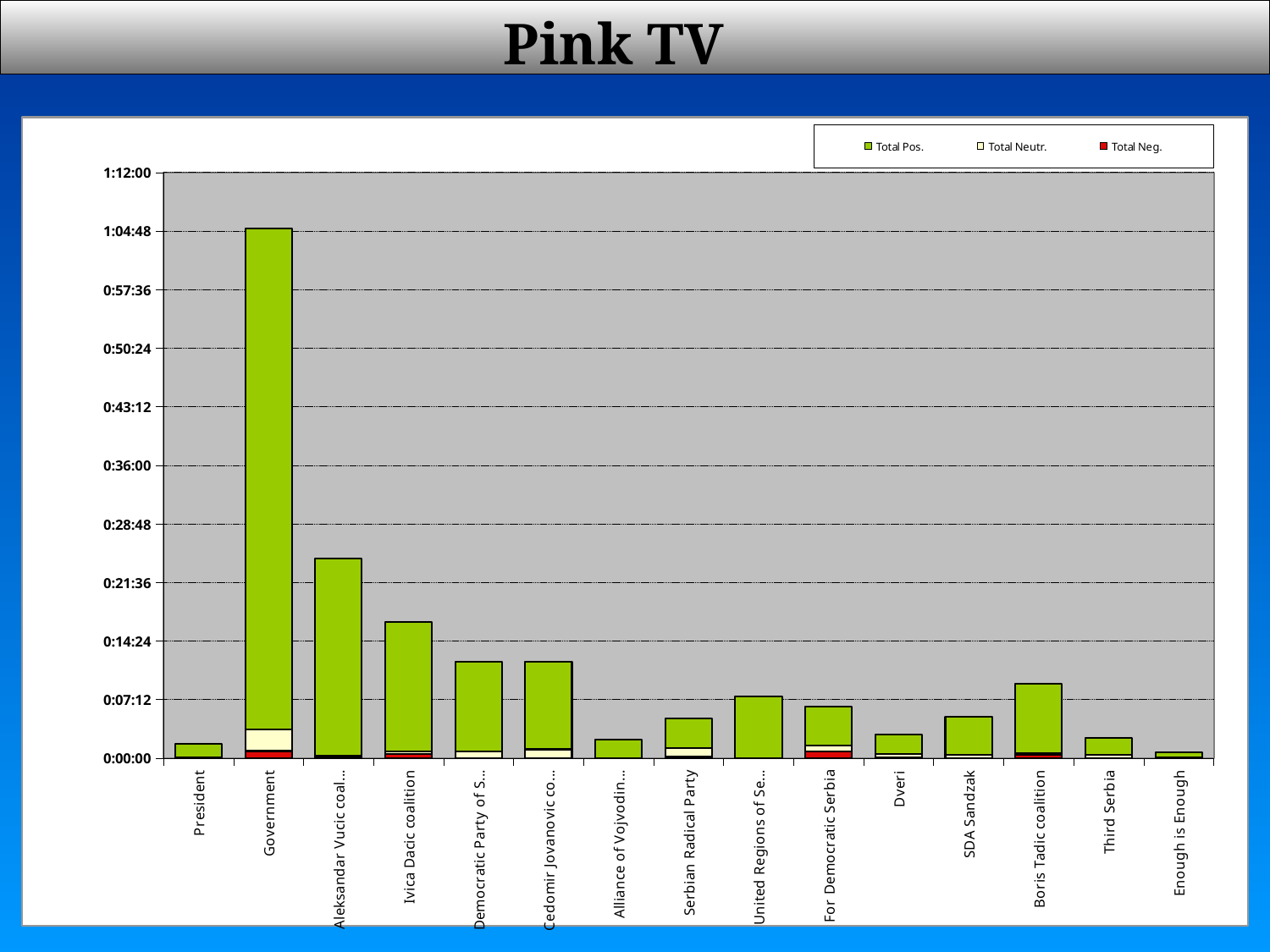
What are the three legend entries of the chart? Total Pos., Total Neutr., Total Neg. Is the total bar for Boris Tadic coalition greater or less than 0:07:12? greater Is the total bar for President greater or less than 0:07:12? less Which has the taller bar, Ivica Dacic coalition or Serbian Radical Party? Ivica Dacic coalition Which category has the shortest bar? Enough is Enough How many series does the legend list? 3 Which has the taller bar, Boris Tadic coalition or Third Serbia? Boris Tadic coalition What kind of chart is shown on the slide? Stacked bar chart Is the total bar for Government greater or less than 0:57:36? greater How many categories are shown on the x axis? 15 Which category has the tallest bar? Government